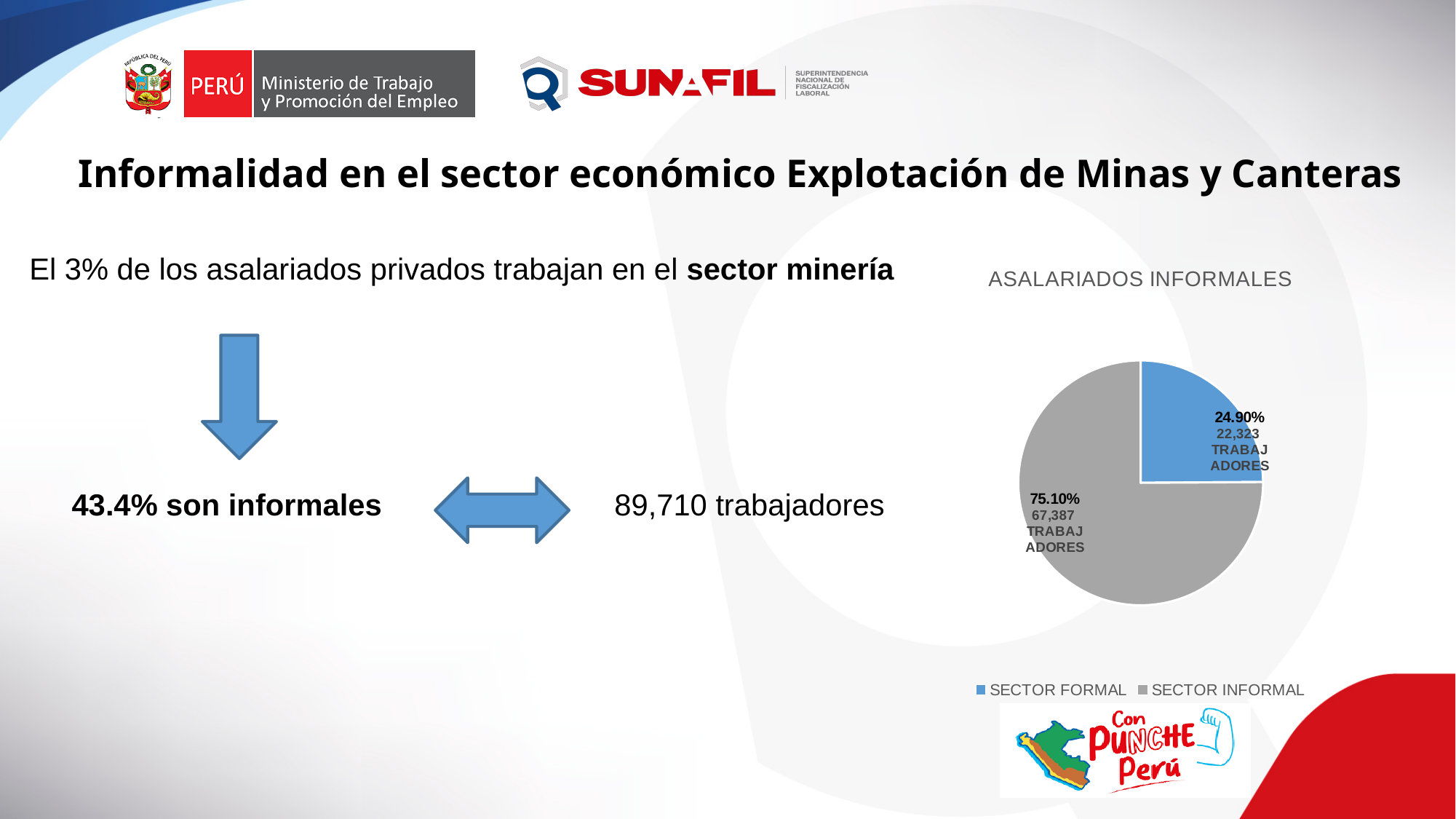
How many slices does the pie chart have? 2 What kind of chart is shown on the slide? pie chart Which slice of the pie chart is the largest? SECTOR INFORMAL How many entries does the chart legend list? 2 How many trabajadores are shown for SECTOR FORMAL? 22,323 What percentage share does SECTOR FORMAL have in the pie chart? 24.90% How many trabajadores are shown for SECTOR INFORMAL? 67,387 What percentage share does SECTOR INFORMAL have in the pie chart? 75.10% What is the title of the chart? ASALARIADOS INFORMALES What is the difference in trabajadores between SECTOR INFORMAL and SECTOR FORMAL? 45,064 Which slice of the pie chart is the smallest? SECTOR FORMAL Which has more trabajadores, SECTOR FORMAL or SECTOR INFORMAL? SECTOR INFORMAL